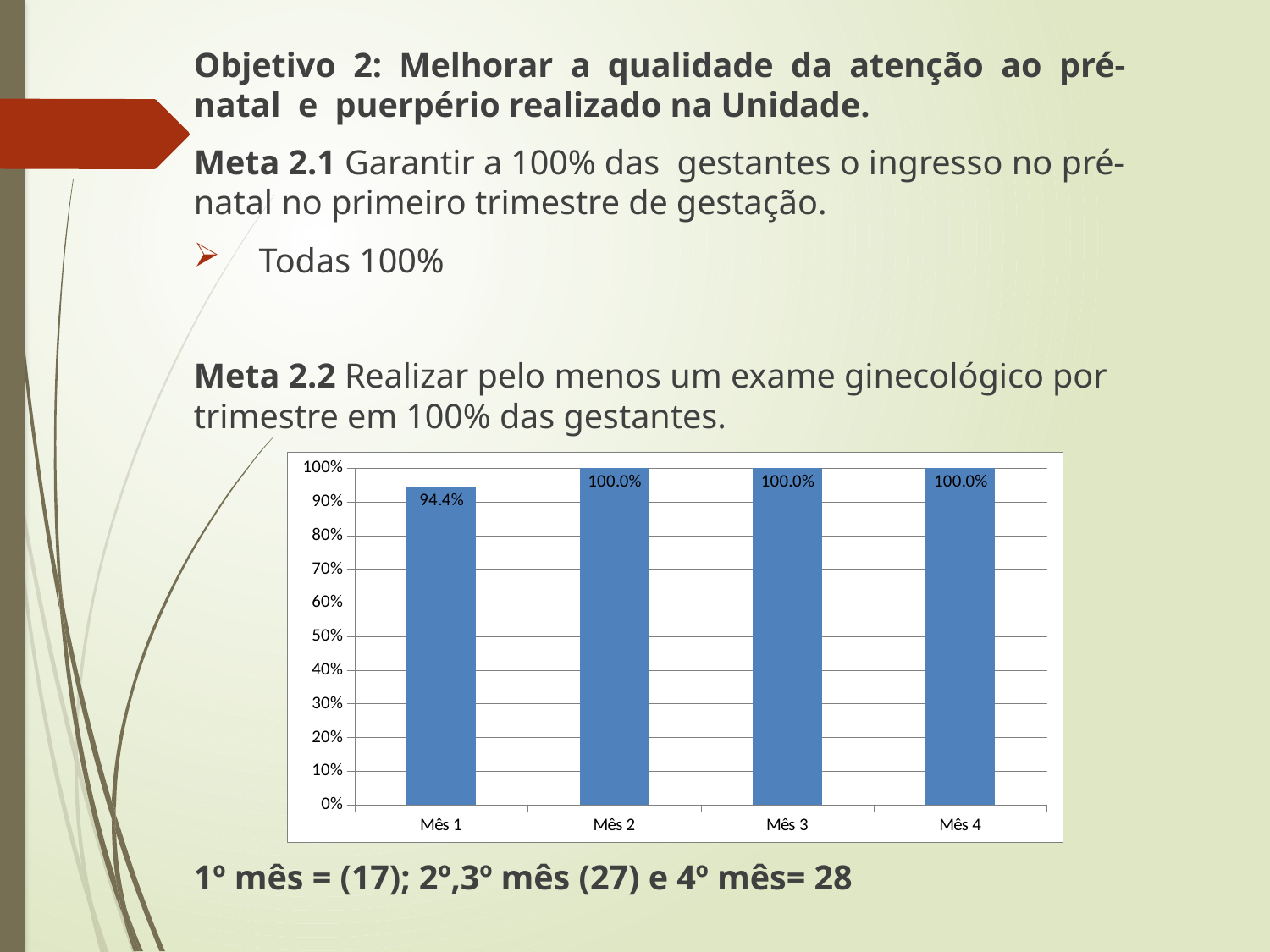
What is the value for Mês 1? 94.4% What is the highest tick shown on the y axis? 100% What kind of chart is shown on the slide? bar chart Which month has the lowest value? Mês 1 What is the difference between the values for Mês 2 and Mês 1? 5.6% Do the values rise or fall from Mês 1 to Mês 2? rise What is the value for Mês 4? 100.0% What is the value for Mês 2? 100.0% How many months have a value of 100.0%? 3 How many months are shown on the x axis? 4 Is the value for Mês 1 greater or less than 90%? greater Which is larger, the value for Mês 1 or the value for Mês 3? Mês 3